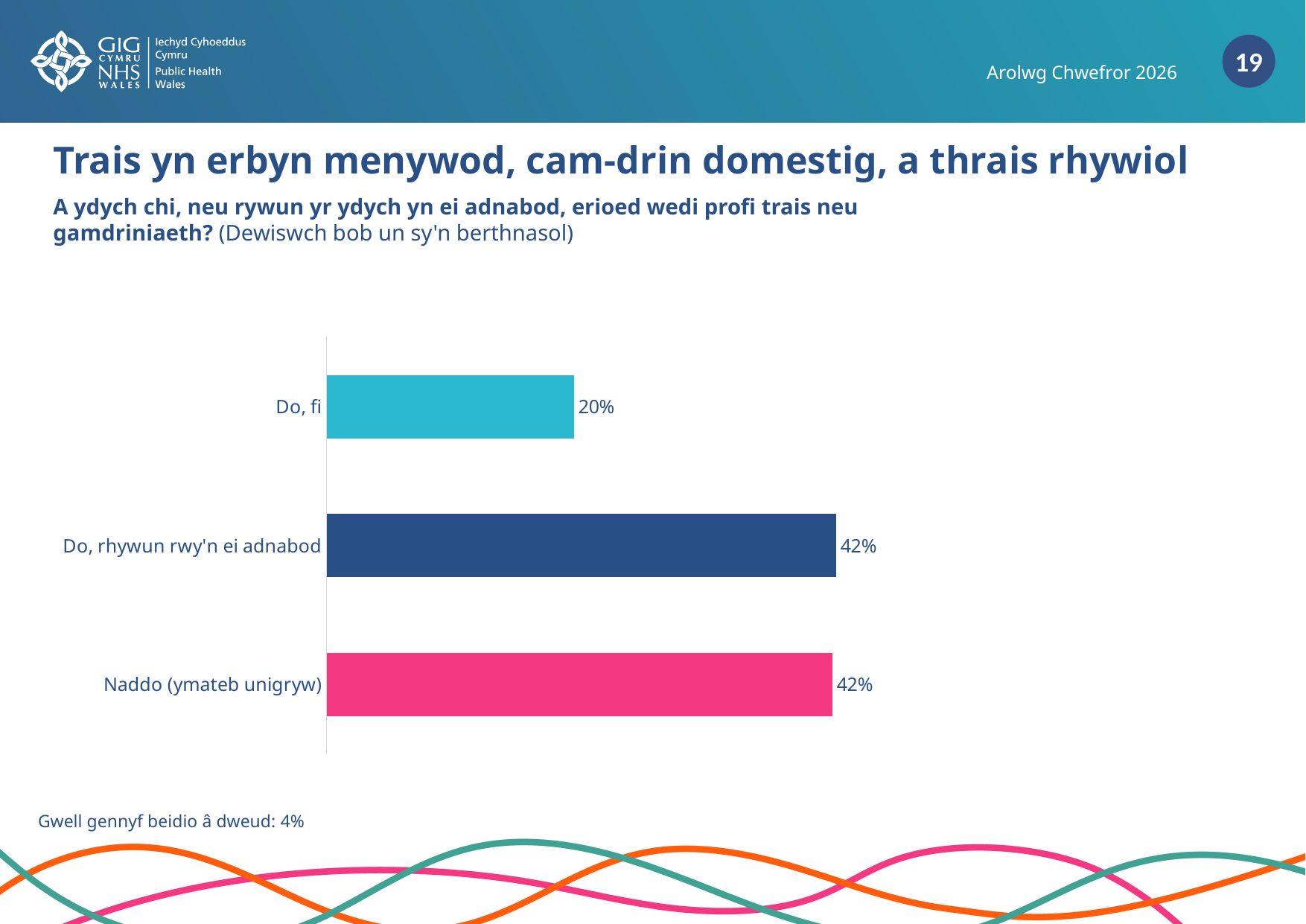
Which category is shown at the top of the chart? Do, fi What is the value for "Naddo (ymateb unigryw)"? 42% Which category has the lowest value? Do, fi How many categories are shown in the chart? 3 What is the value for "Do, fi"? 20% What is the difference between the values for "Naddo (ymateb unigryw)" and "Do, fi"? 22 percentage points Which is larger, the value for "Do, fi" or the value for "Do, rhywun rwy'n ei adnabod"? Do, rhywun rwy'n ei adnabod Do "Do, rhywun rwy'n ei adnabod" and "Naddo (ymateb unigryw)" have the same value? Yes, both 42% What is the value for "Do, rhywun rwy'n ei adnabod"? 42% What colour is the bar for "Naddo (ymateb unigryw)"? Pink What percentage is given for "Gwell gennyf beidio â dweud" in the note below the chart? 4% What kind of chart is shown on the slide? Bar chart